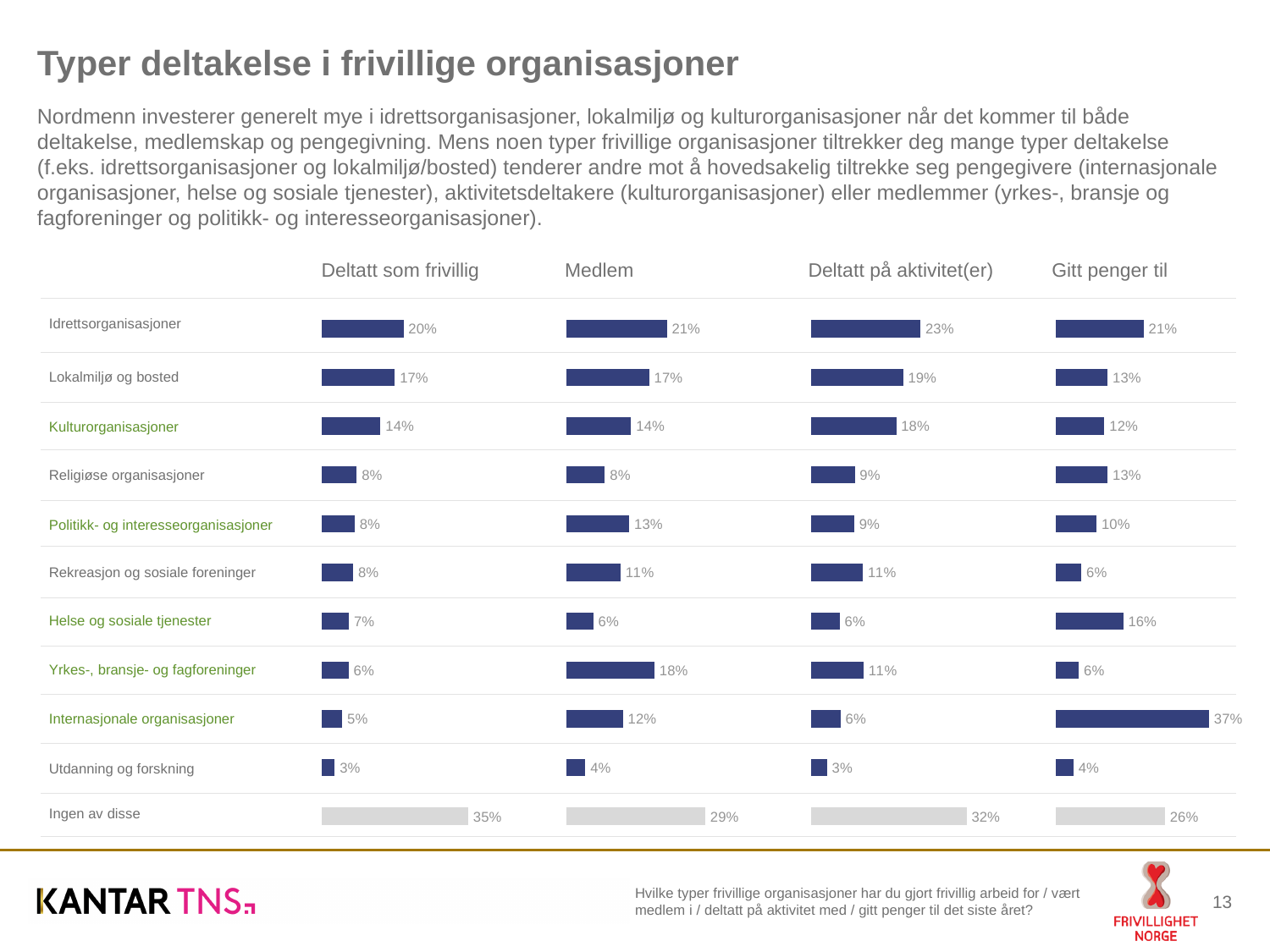
In the "Gitt penger til" chart, what is the difference between Internasjonale organisasjoner and Helse og sosiale tjenester? 21% In the "Gitt penger til" chart, what is the value for Internasjonale organisasjoner? 37% In the "Medlem" chart, which is larger: Politikk- og interesseorganisasjoner or Rekreasjon og sosiale foreninger? Politikk- og interesseorganisasjoner In the "Medlem" chart, what is the value for Yrkes-, bransje- og fagforeninger? 18% In the "Gitt penger til" chart, which category has the lowest value? Utdanning og forskning In the "Deltatt på aktivitet(er)" chart, which is larger: Kulturorganisasjoner or Religiøse organisasjoner? Kulturorganisasjoner How many categories are listed in the "Deltatt som frivillig" chart? 11 In the "Deltatt på aktivitet(er)" chart, which category has the highest value? Ingen av disse What kind of chart is the "Medlem" chart? Bar chart In the "Deltatt som frivillig" chart, what is the value for Idrettsorganisasjoner? 20% In the "Deltatt på aktivitet(er)" chart, what is the value for Lokalmiljø og bosted? 19% In the "Deltatt som frivillig" chart, what is the difference between Idrettsorganisasjoner and Lokalmiljø og bosted? 3%